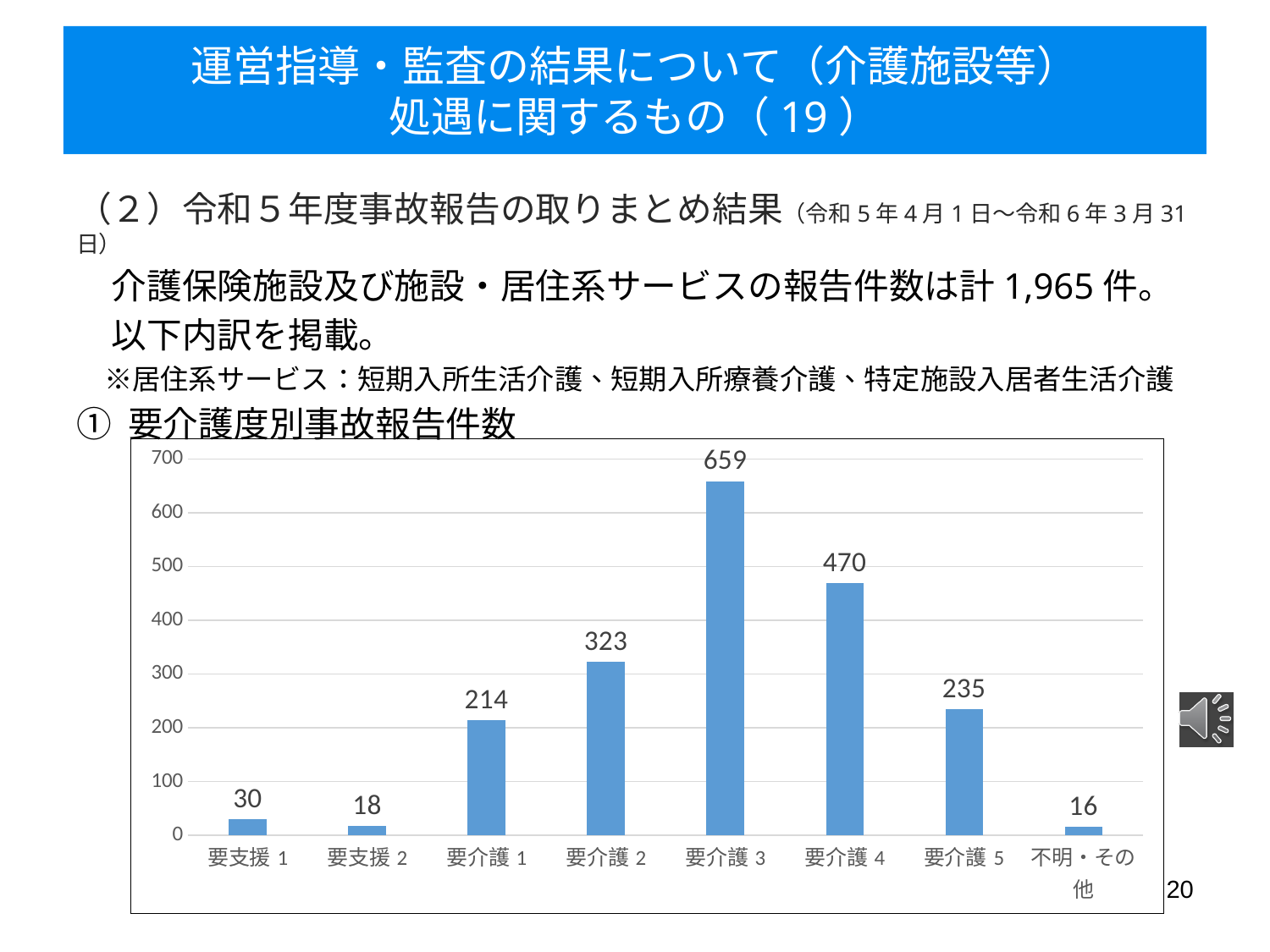
What kind of chart is shown on the slide? bar chart Is the value for 要介護4 greater or less than 400? greater Which category has the highest value? 要介護3 Which is larger, the value for 要介護5 or the value for 要介護1? 要介護5 What is the value for 要介護3? 659 What is the value for 要支援1? 30 What is the difference between the values for 要介護3 and 要介護4? 189 Which category has the lowest value? 不明・その他 What is the value for 不明・その他? 16 What is the difference between the values for 要介護2 and 要介護1? 109 How many categories are shown on the x axis? 8 What is the title of the chart section (①)? 要介護度別事故報告件数